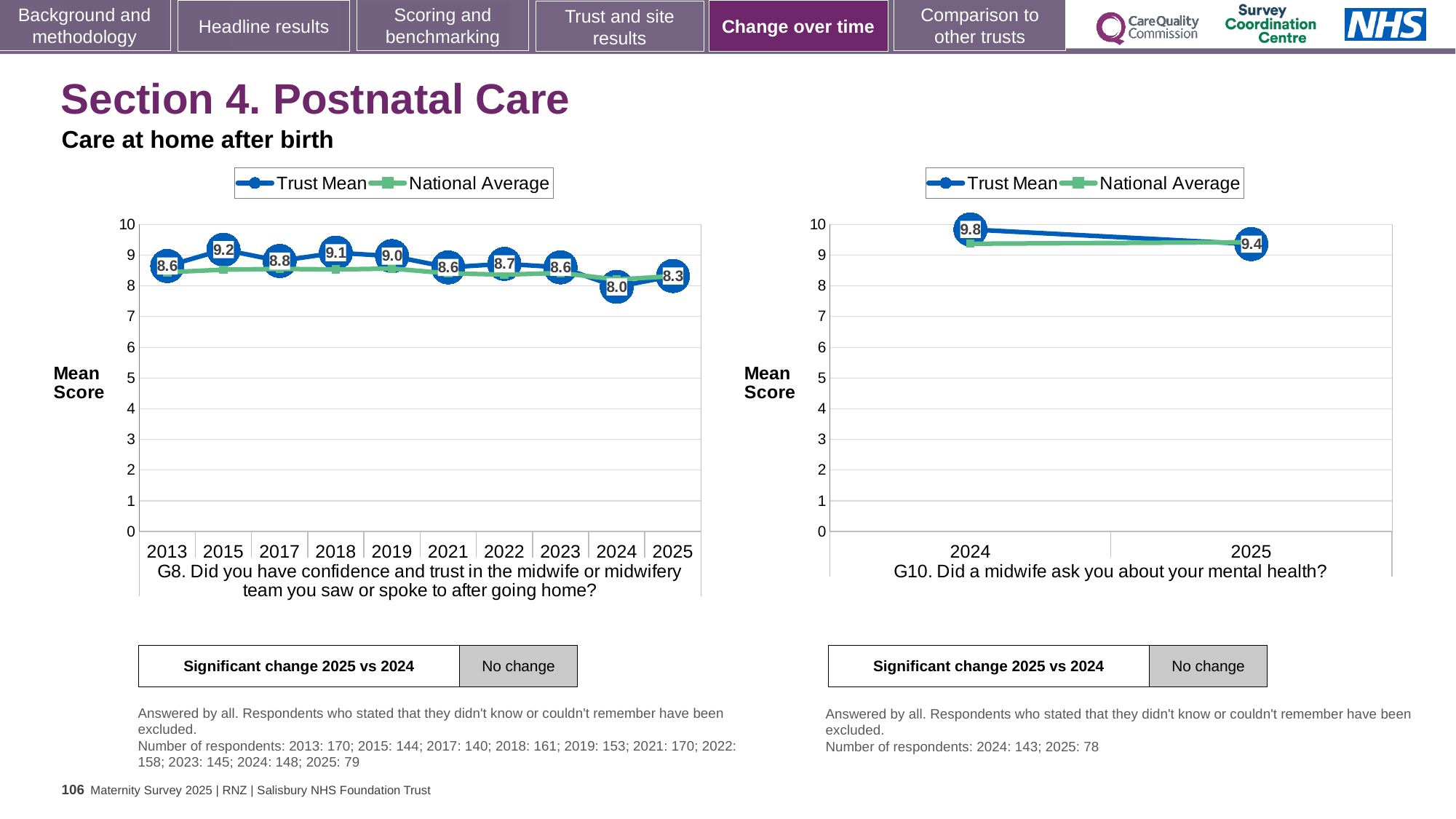
In the G10 chart on the right, what is the difference between the Trust Mean scores for 2024 and 2025? 0.4 How many years are shown on the x axis of the G8 chart on the left? 10 In the G8 chart on the left, is the National Average for 2013 greater or less than 8? greater In the G10 chart on the right, what is the Trust Mean score for 2025? 9.4 In the G8 chart on the left, which year has the lowest Trust Mean score? 2024 In the G8 chart on the left, what is the Trust Mean score for 2024? 8.0 In the G10 chart on the right, does the Trust Mean rise or fall from 2024 to 2025? Fall In the G8 chart on the left, which year has the highest Trust Mean score? 2015 In the G8 chart on the left, is the Trust Mean score higher in 2018 or in 2025? 2018 What type of chart is the G10 chart on the right? Line chart How many series does the legend of the G10 chart on the right list? 2 In the G8 chart on the left, what is the Trust Mean score for 2015? 9.2